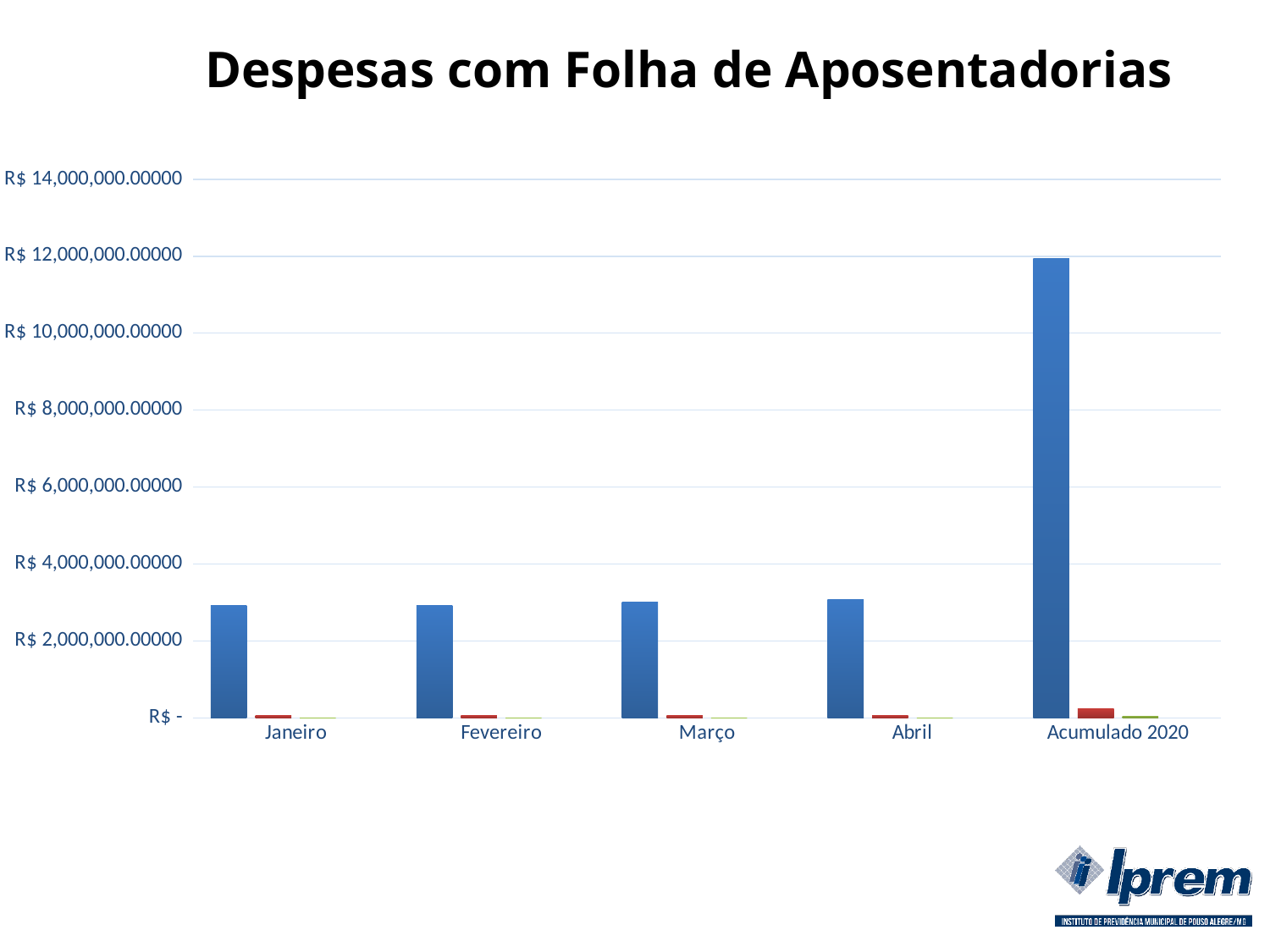
What is the title of the chart? Despesas com Folha de Aposentadorias Which is larger for Janeiro, the blue bar or the red bar? the blue bar Is the blue bar for Acumulado 2020 greater or less than R$ 10,000,000.00000? greater How many categories are shown on the x axis? 5 Which category has the tallest blue bar? Acumulado 2020 Is the blue bar for Abril greater or less than R$ 4,000,000.00000? less What kind of chart is shown on the slide? bar chart How many bars are shown for each category? 3 Which is larger, the blue bar for Acumulado 2020 or the blue bar for Março? Acumulado 2020 Is the blue bar for Janeiro greater or less than R$ 2,000,000.00000? greater What is the label of the last category on the x axis? Acumulado 2020